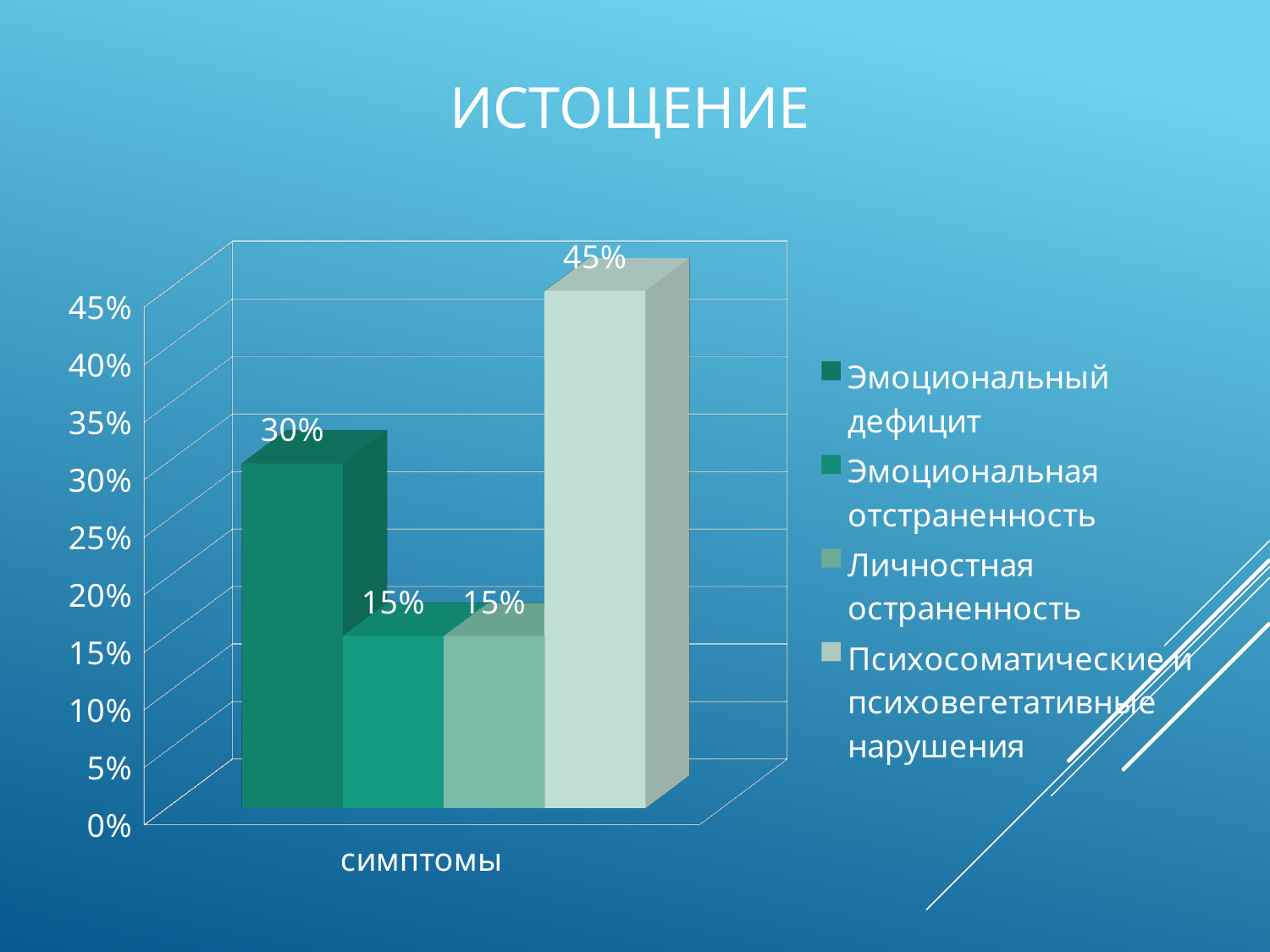
What is the difference between the values for Эмоциональный дефицит and Личностная остраненность? 15% What is the title of the slide? ИСТОЩЕНИЕ Which series has the highest value? Психосоматические и психовегетативные нарушения What value is shown for Эмоциональный дефицит? 30% What is the label on the x axis? симптомы What value is shown for Эмоциональная отстраненность? 15% What kind of chart is shown on the slide? Bar chart How many series does the legend list? 4 What value is shown for Психосоматические и психовегетативные нарушения? 45% Which is larger: the value for Эмоциональный дефицит or the value for Эмоциональная отстраненность? Эмоциональный дефицит What is the difference between the values for Психосоматические и психовегетативные нарушения and Эмоциональный дефицит? 15% What value is shown for Личностная остраненность? 15%